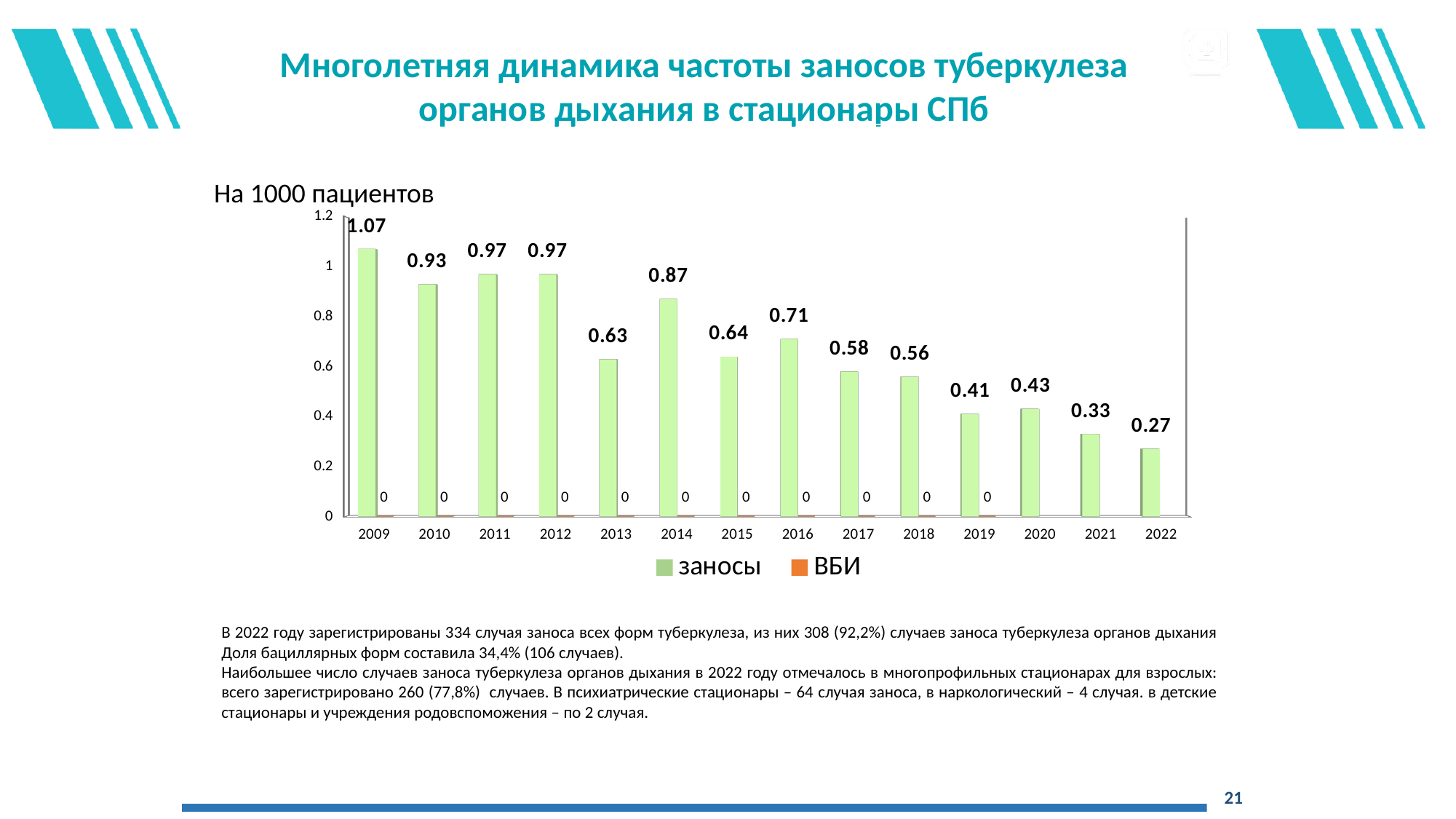
Which year has the lowest value for заносы? 2022 What is the value for заносы in 2014? 0.87 Which year has the highest value for заносы? 2009 What is the difference between the заносы values for 2009 and 2022? 0.80 How many series does the legend list? 2 How many years are shown on the x axis? 14 Which year has a larger заносы value, 2013 or 2016? 2016 What kind of chart is shown on the slide? bar chart What is the value for заносы in 2009? 1.07 What is the value for ВБИ in 2015? 0 What is the value for заносы in 2022? 0.27 Do the заносы values generally rise or fall from 2009 to 2022? fall